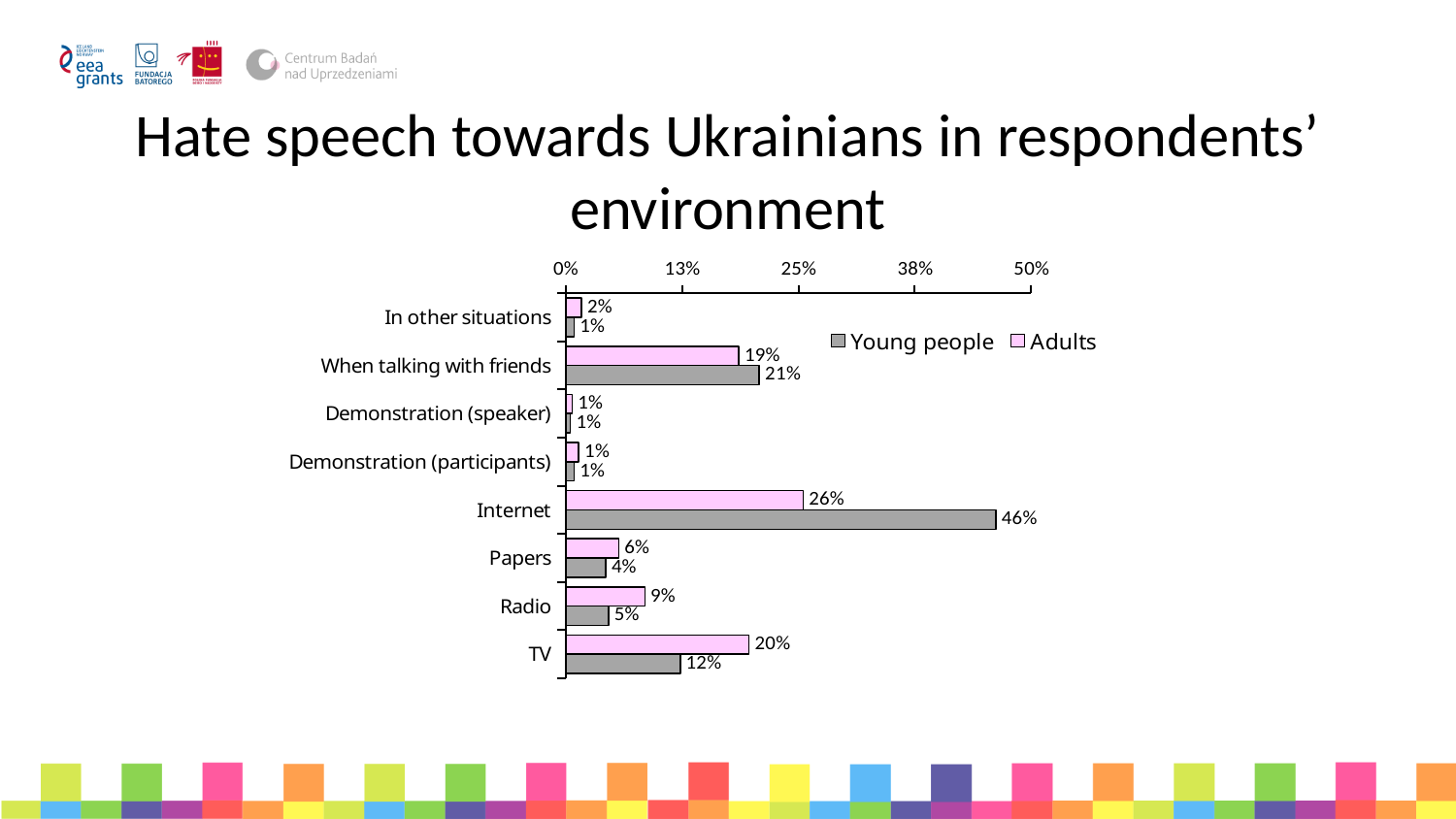
What is the value for Adults for When talking with friends? 19% What is the value for Young people for Internet? 46% What is the value for Adults for TV? 20% What is the difference between the Young people and Adults values for Internet? 20% Is the value for Young people for Internet greater or less than 38%? greater What kind of chart is shown on the slide? bar chart For Radio, which series has the larger value, Young people or Adults? Adults Which category has the highest value for Young people? Internet How many series does the legend list? 2 How many categories are shown on the chart? 8 What is the difference between the Adults and Young people values for TV? 8% Which category has the highest value for Adults? Internet